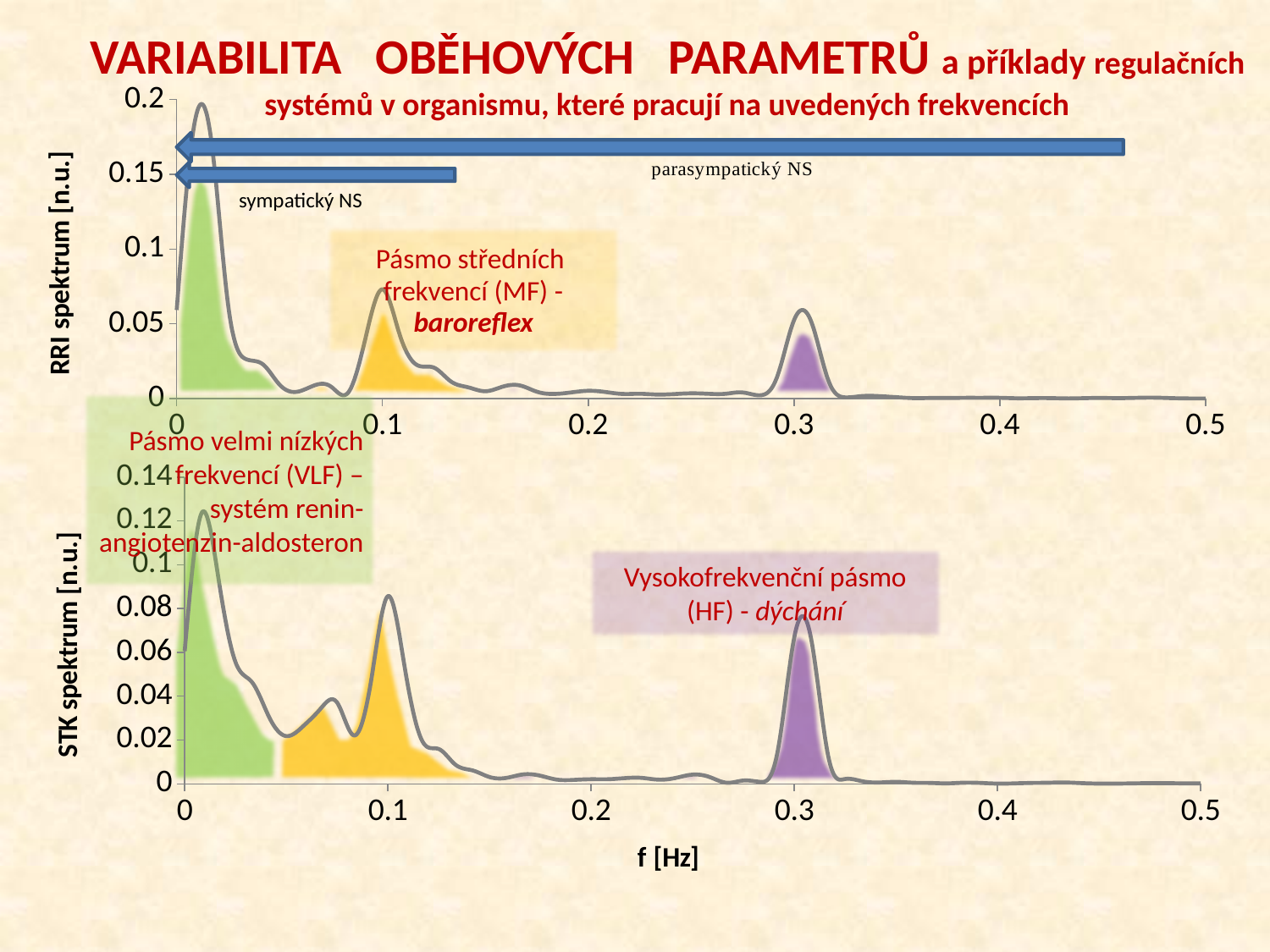
In the bottom chart (STK spektrum), is the peak of the yellow MF band (near 0.1 Hz) greater or less than 0.1? less In the top chart (RRI spektrum), which coloured band contains the highest peak: green (VLF), yellow (MF) or purple (HF)? green (VLF) In the top chart (RRI spektrum), is the peak of the purple HF band (near 0.3 Hz) greater or less than 0.1? less In the bottom chart (STK spektrum), which is higher: the peak of the green VLF band or the peak of the purple HF band? green VLF band In the top chart (RRI spektrum), is the peak of the yellow MF band (near 0.1 Hz) greater or less than 0.1? less What is the maximum value shown on the x axis of the bottom chart (STK spektrum)? 0.5 What is the x-axis label shared by the two charts? f [Hz] What kind of chart is the top chart (RRI spektrum)? line chart What is the y-axis label of the top chart? RRI spektrum [n.u.]